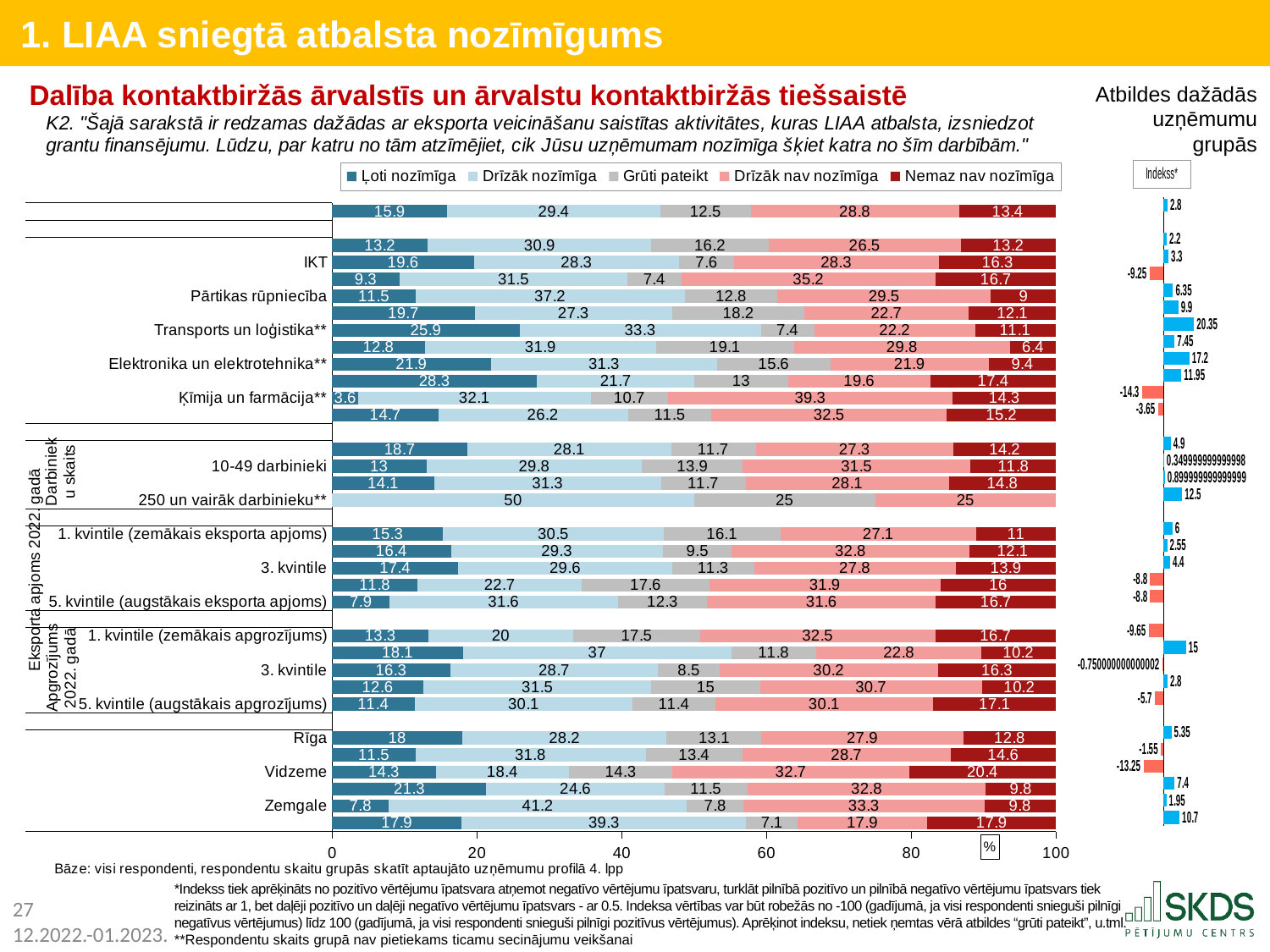
In the main chart, which is larger for Rīga: the 'Ļoti nozīmīga' value or the 'Nemaz nav nozīmīga' value? Ļoti nozīmīga In the main chart, what is the 'Drīzāk nav nozīmīga' value for Ķīmija un farmācija**? 39.3 In the main chart, what is the 'Nemaz nav nozīmīga' value for Vidzeme? 20.4 How many series does the legend of the main chart list? 5 What kind of chart is the main chart on the slide? stacked bar chart In the main chart, what is the difference between the 'Drīzāk nozīmīga' values for Pārtikas rūpniecība and IKT? 8.9 In the main chart, what is the 'Drīzāk nozīmīga' value for 250 un vairāk darbinieku**? 50 In the main chart, what is the 'Ļoti nozīmīga' value for 5. kvintile (augstākais eksporta apjoms)? 7.9 In the main chart, what is the 'Ļoti nozīmīga' value for Transports un loģistika**? 25.9 Which legend entry of the main chart is shown in the darkest red colour? Nemaz nav nozīmīga In the main chart, what is the 'Drīzāk nozīmīga' value for Zemgale? 41.2 In the main chart, what is the 'Grūti pateikt' value for Elektronika un elektrotehnika**? 15.6